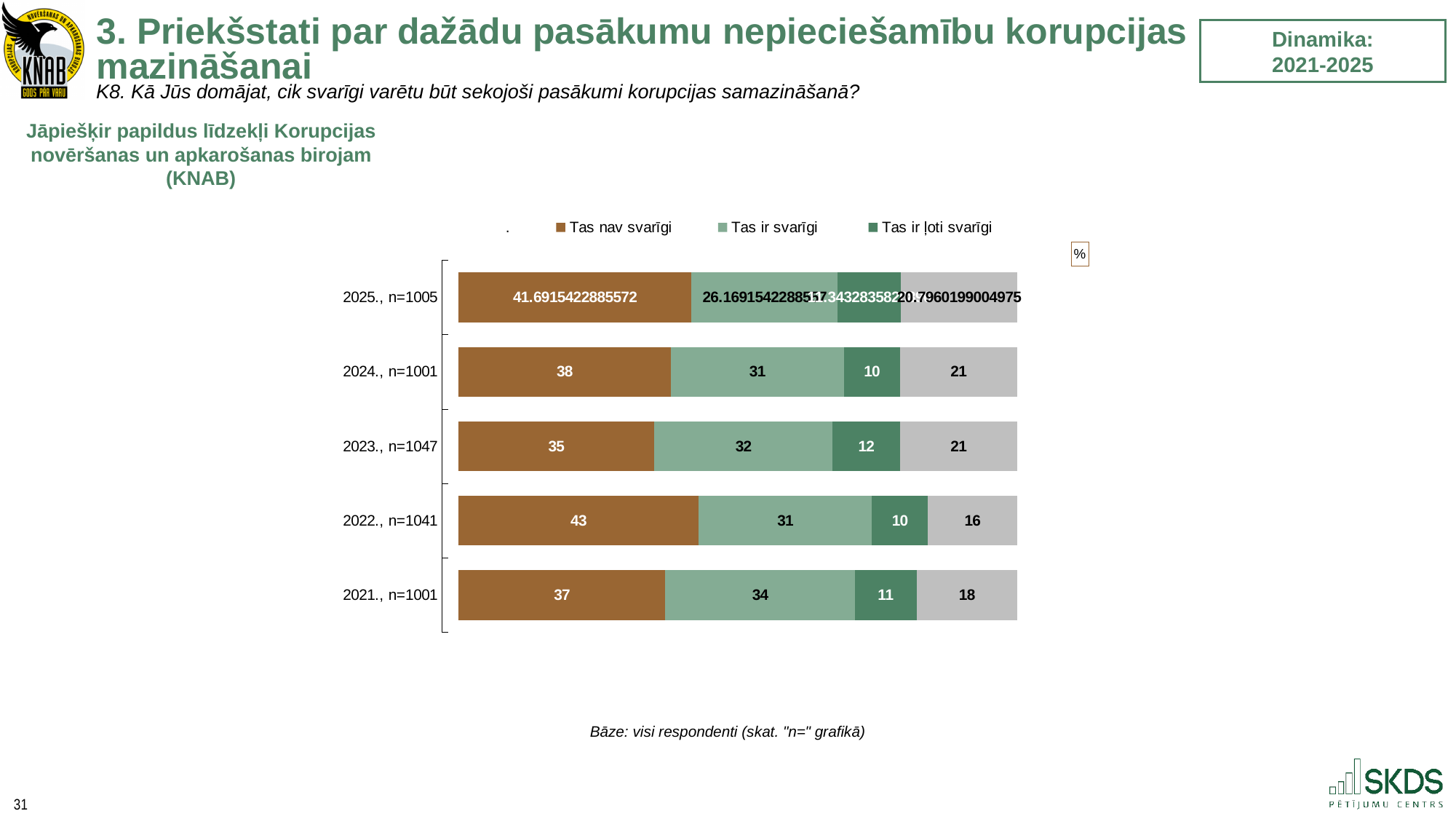
How many year categories are shown on the chart? 5 What is the value for "Tas nav svarīgi" in 2024., n=1001? 38 Among the years 2021 to 2024, which year has the lowest value for "Tas nav svarīgi"? 2023., n=1047 Which legend entry is shown in brown? Tas nav svarīgi Among the years 2021 to 2024, which year has the highest value for "Tas nav svarīgi"? 2022., n=1041 What is the value for "Tas nav svarīgi" in 2022., n=1041? 43 What kind of chart is shown on the slide? stacked bar chart What is the value for "Tas ir svarīgi" in 2021., n=1001? 34 Which is larger: the "Tas ir svarīgi" value for 2023., n=1047 or for 2024., n=1001? 2023., n=1047 What is the difference between the "Tas nav svarīgi" values for 2022., n=1041 and 2021., n=1001? 6 What is the total of the stacked bar for 2024., n=1001? 100 What is the value for "Tas ir ļoti svarīgi" in 2023., n=1047? 12